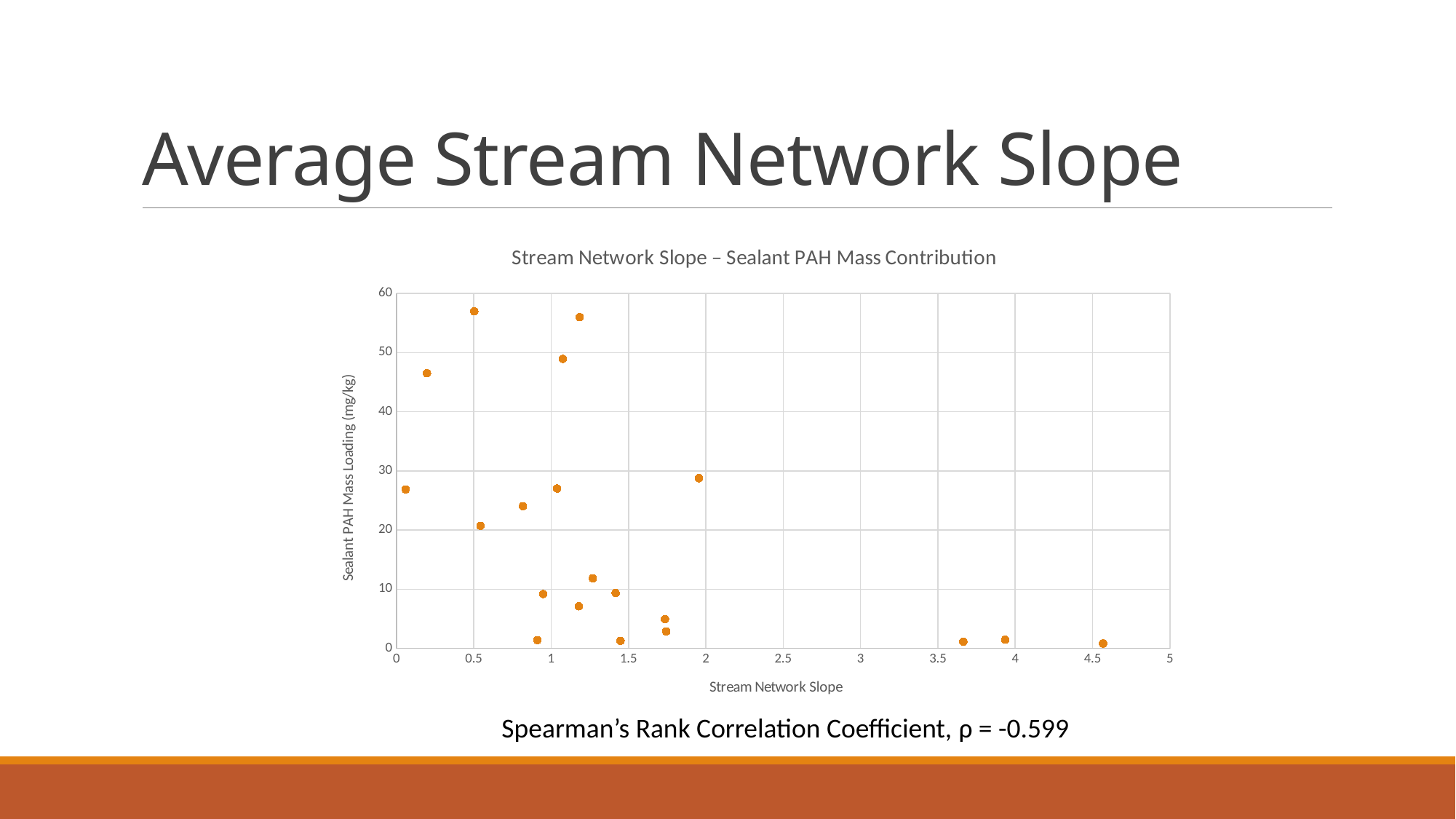
Which is larger: the Sealant PAH Mass Loading of the point near slope 0.5 (top left) or the point near slope 1.95? the point near slope 0.5 Overall, do the Sealant PAH Mass Loading values tend to rise or fall as Stream Network Slope increases? fall Is the highest Sealant PAH Mass Loading value on the chart greater or less than 50? greater What is the maximum value shown on the vertical axis? 60 Is the Sealant PAH Mass Loading for the point at a Stream Network Slope of about 0.2 greater or less than 40? greater What is the label of the vertical axis of the chart? Sealant PAH Mass Loading (mg/kg) What kind of chart is shown on the slide? scatter plot Are all points with a Stream Network Slope greater than 3 below a Sealant PAH Mass Loading of 10? yes How many data points are plotted on the chart? 20 What is the title of the chart? Stream Network Slope – Sealant PAH Mass Contribution